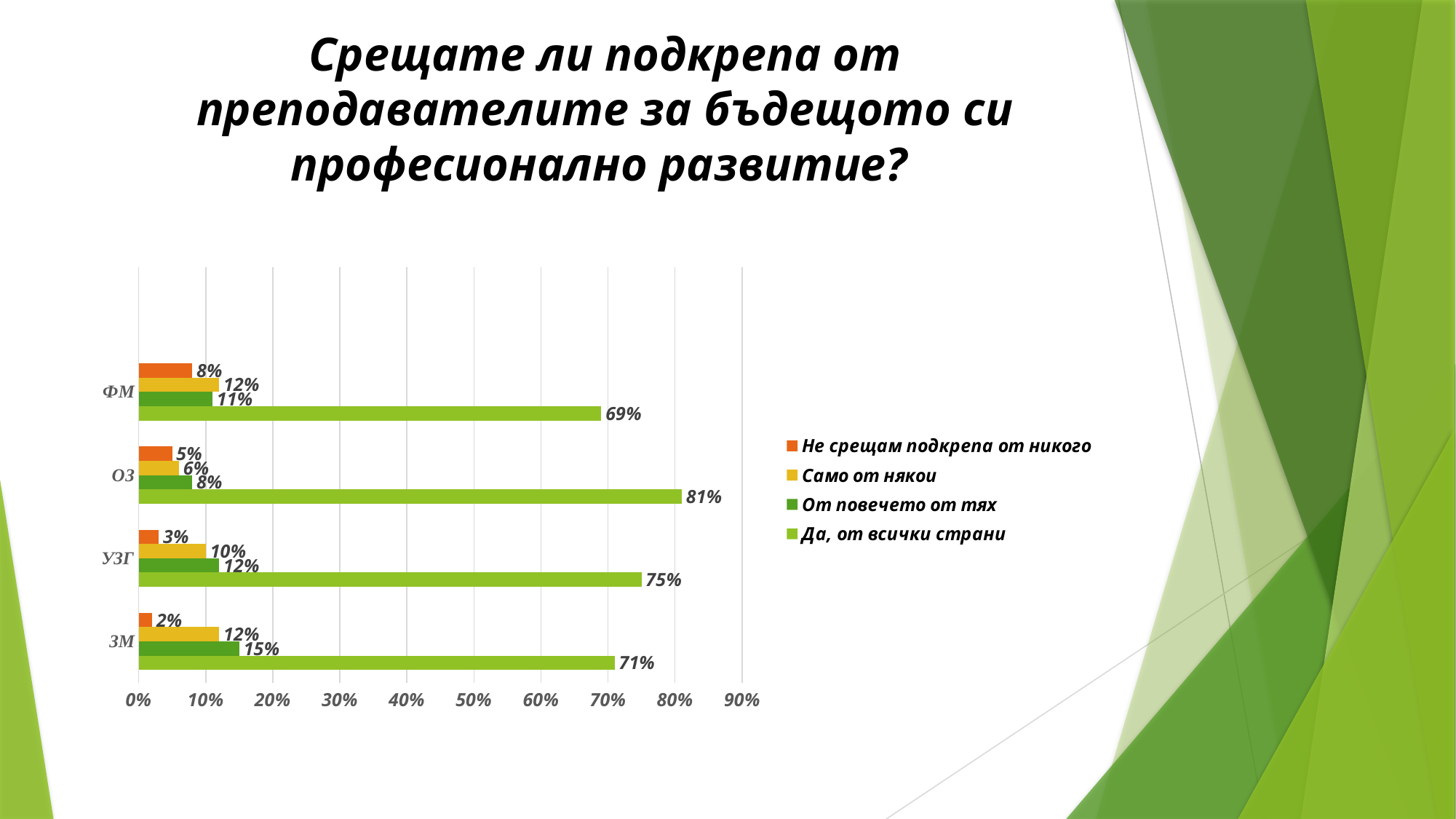
What is the value for "От повечето от тях" for ЗМ? 15% How many series does the legend list? 4 Which category has the lowest value for "Не срещам подкрепа от никого"? ЗМ What is the value for "Само от някои" for УЗГ? 10% How many categories are shown on the vertical axis? 4 What is the difference between the "Да, от всички страни" values for ОЗ and ФМ? 12% Which is larger: the "От повечето от тях" value for ЗМ or for ОЗ? ЗМ Which legend entry is shown in orange? Не срещам подкрепа от никого What is the value for "Да, от всички страни" for ОЗ? 81% Which category has the highest value for "Да, от всички страни"? ОЗ What kind of chart is shown on the slide? Bar chart What is the value for "Не срещам подкрепа от никого" for ФМ? 8%